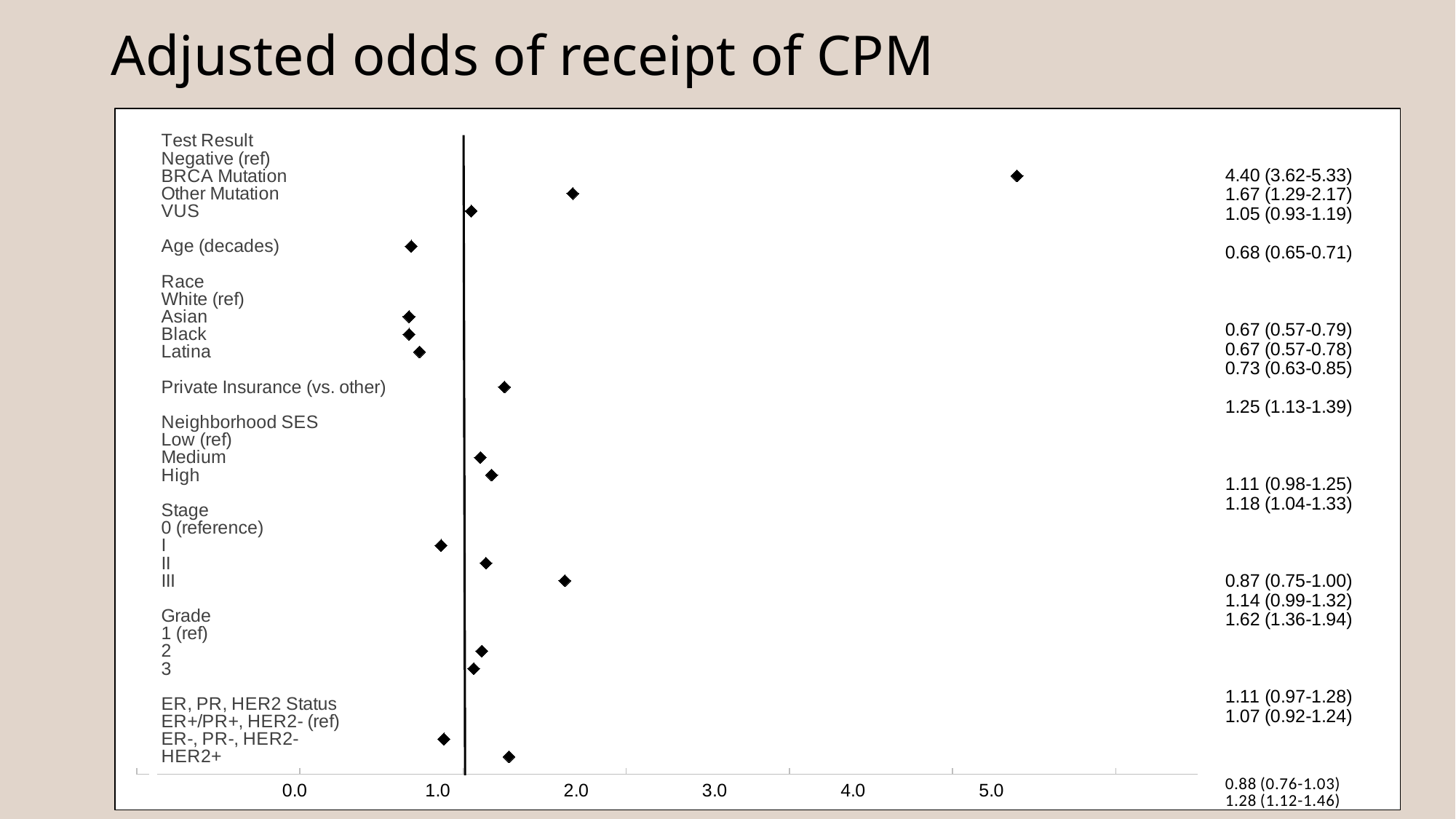
What is the title of the slide? Adjusted odds of receipt of CPM What is the difference between the odds ratio point estimates for BRCA Mutation and Other Mutation? 2.73 What is the adjusted odds ratio printed for Latina? 0.73 (0.63-0.85) What is the adjusted odds ratio printed for Stage III? 1.62 (1.36-1.94) What is the adjusted odds ratio printed for Age (decades)? 0.68 (0.65-0.71) What is the adjusted odds ratio printed for Private Insurance (vs. other)? 1.25 (1.13-1.39) How many odds ratio points are plotted on the chart? 17 Which category has the highest adjusted odds ratio? BRCA Mutation What is the adjusted odds ratio printed for BRCA Mutation? 4.40 (3.62-5.33) Which has the larger odds ratio point estimate, Stage I or Stage III? Stage III What is the adjusted odds ratio printed for HER2+? 1.28 (1.12-1.46) Which Test Result category has the lowest adjusted odds ratio? VUS